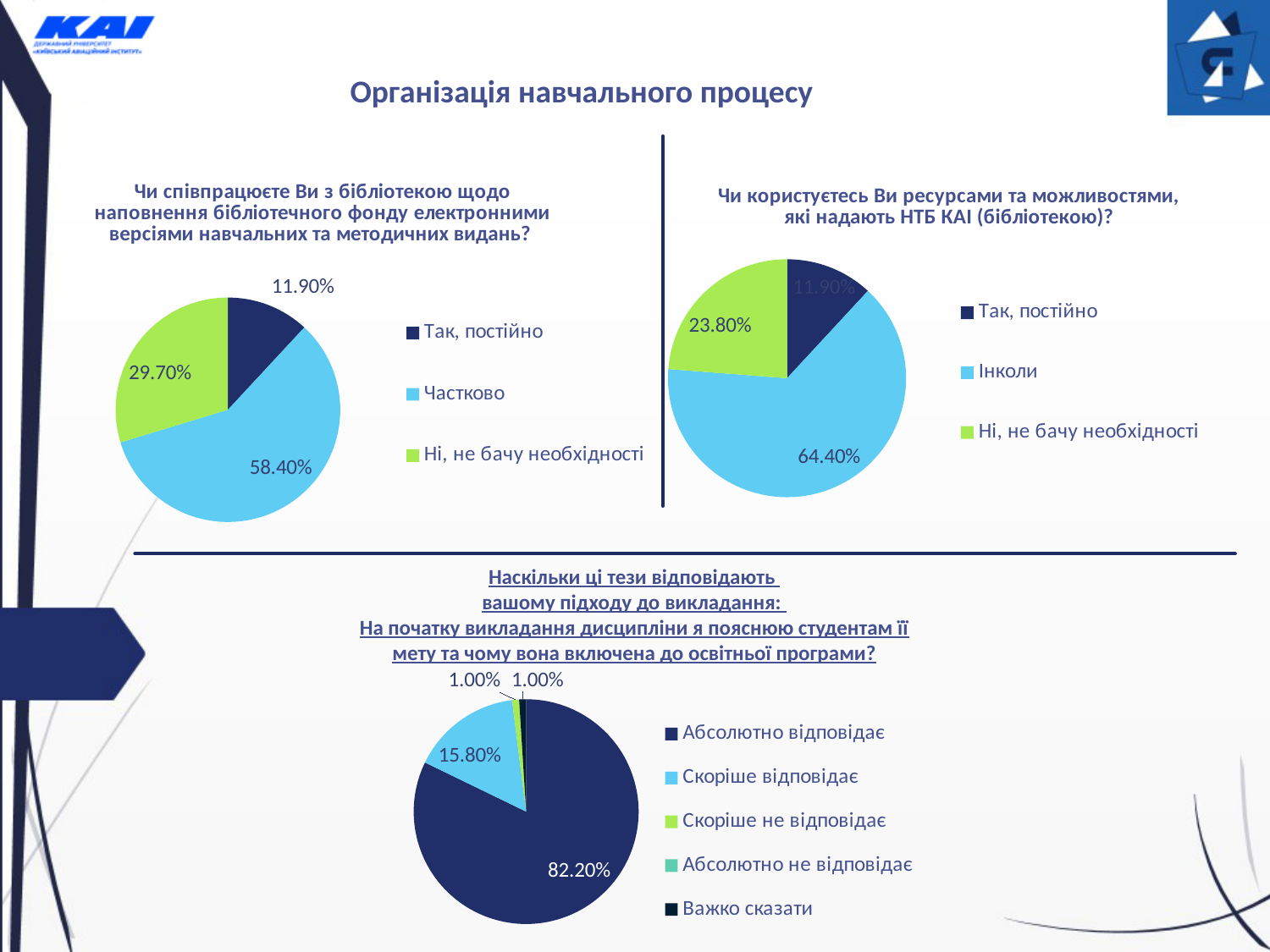
In the top-left pie chart, what percentage is shown for "Частково"? 58.40% In the top-right pie chart, what percentage is shown for "Інколи"? 64.40% In the top-left pie chart, which category has the smallest share? Так, постійно In the top-left pie chart, what is the difference between the shares for "Частково" and "Ні, не бачу необхідності"? 28.70% In the top-right pie chart, what percentage is shown for "Ні, не бачу необхідності"? 23.80% In the bottom pie chart, what percentage is shown for "Абсолютно відповідає"? 82.20% In the top-left pie chart, which category has the largest share? Частково In the bottom pie chart, what percentage is shown for "Скоріше відповідає"? 15.80% What type of chart is the bottom chart on the slide? Pie chart In the top-left pie chart, what percentage is shown for "Ні, не бачу необхідності"? 29.70% In the top-right pie chart, which category has the largest share? Інколи In the top-right pie chart, how many categories does the legend list? 3